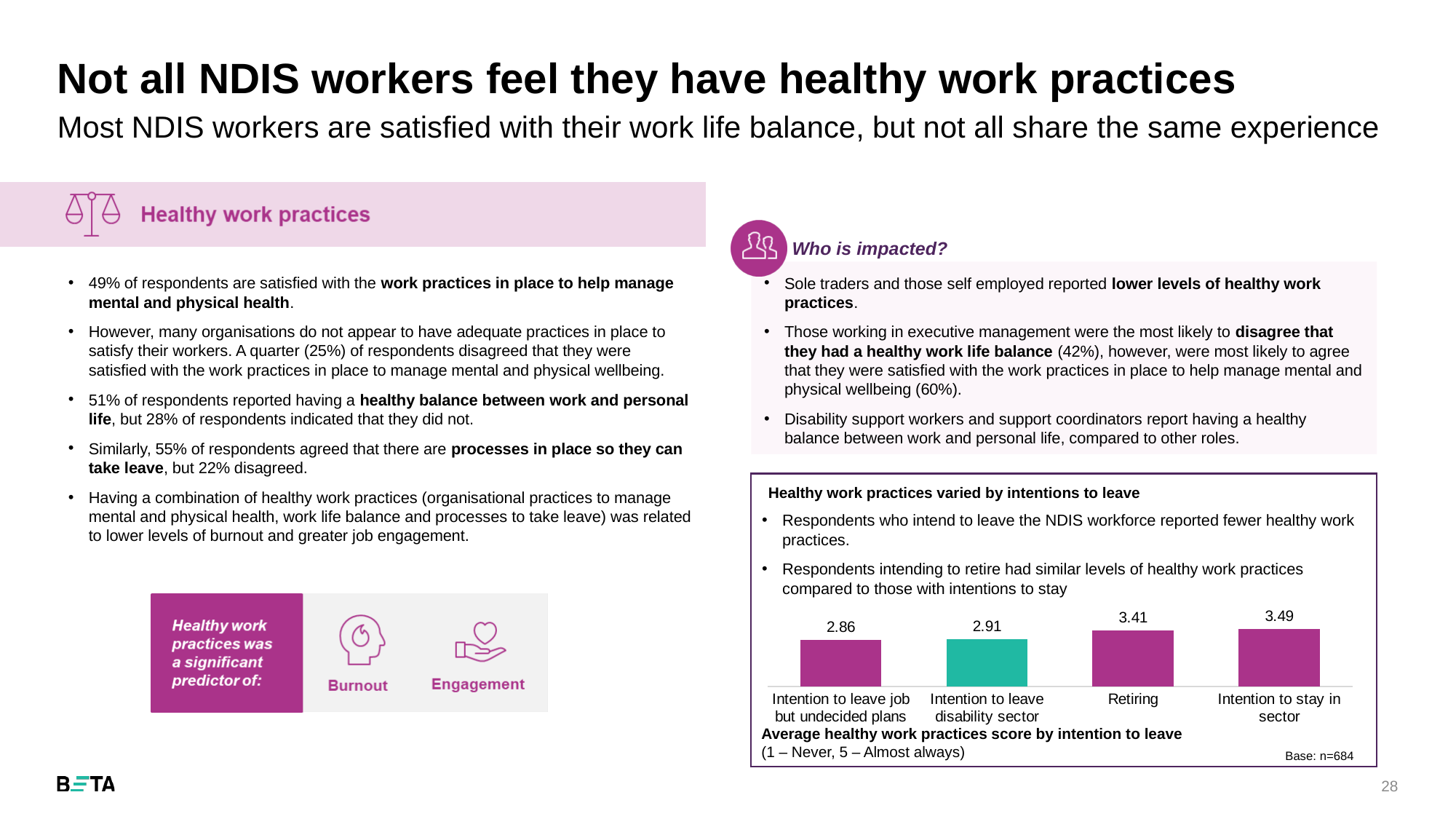
Which has a higher average healthy work practices score: 'Retiring' or 'Intention to leave disability sector'? Retiring What is the average healthy work practices score for respondents with an intention to leave the disability sector? 2.91 Which category has the highest average healthy work practices score? Intention to stay in sector Do the values in the chart rise or fall from left to right? Rise What is the base sample size (n) stated for the chart? n=684 How many categories are shown in the bar chart? 4 What is the difference between the scores for 'Retiring' and 'Intention to leave disability sector'? 0.50 What type of chart is used to show average healthy work practices score by intention to leave? Bar chart What is the average healthy work practices score for respondents who are retiring? 3.41 What is the average healthy work practices score for respondents with an intention to stay in sector? 3.49 What is the difference between the scores for 'Intention to stay in sector' and 'Intention to leave job but undecided plans'? 0.63 Which category has the lowest average healthy work practices score? Intention to leave job but undecided plans